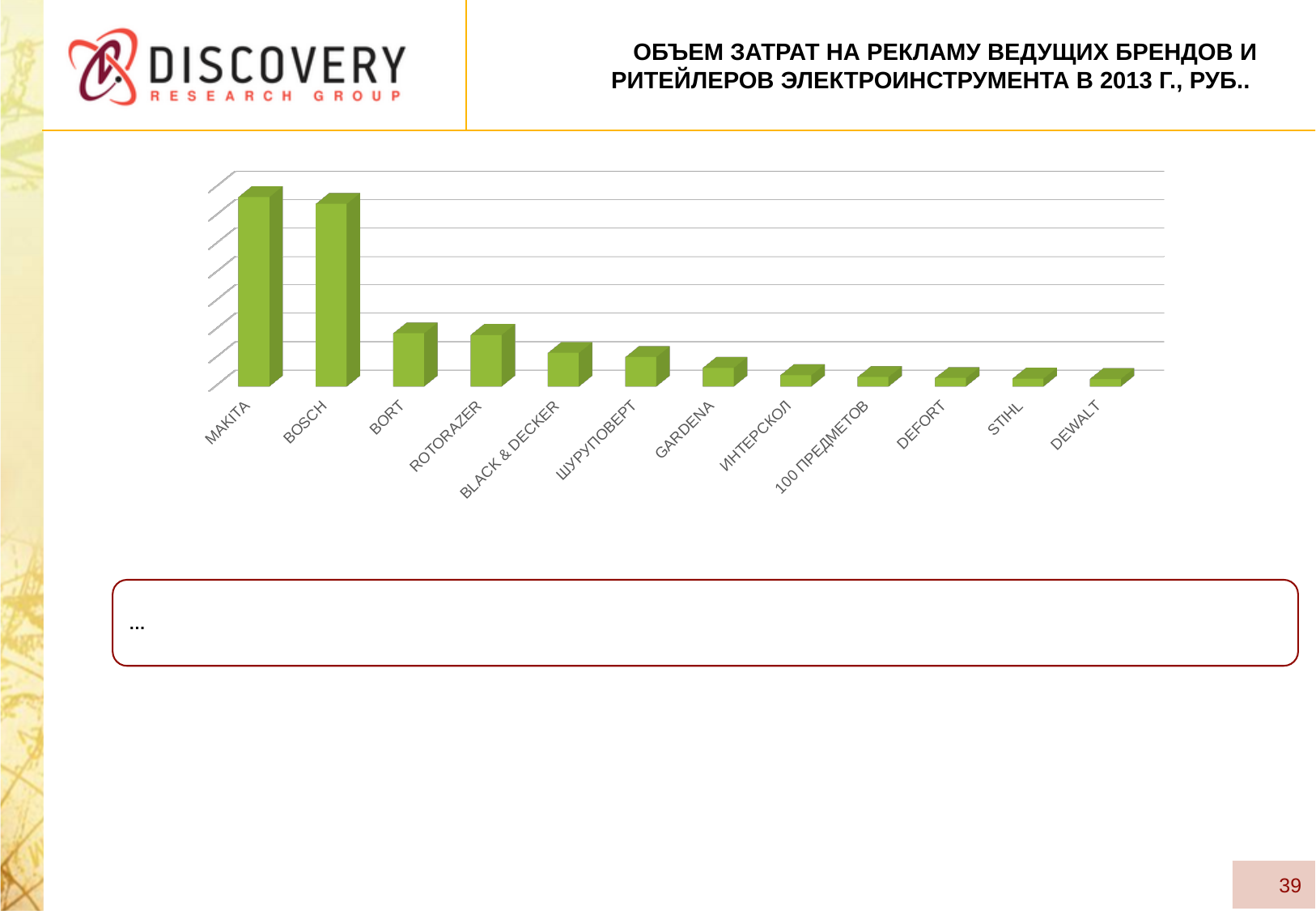
Which is larger, the value for BOSCH or the value for BORT? BOSCH Which is larger, the value for MAKITA or the value for ROTORAZER? MAKITA What colour are the bars in the chart? green Which is larger, the value for BORT or the value for GARDENA? BORT Which brand has the highest advertising spend in the chart? MAKITA How many brands/retailers are shown on the x axis of the chart? 12 Do the values rise or fall moving from left to right along the x axis? fall Which brand is the first (leftmost) category on the x axis? MAKITA What kind of chart is shown on the slide? bar chart